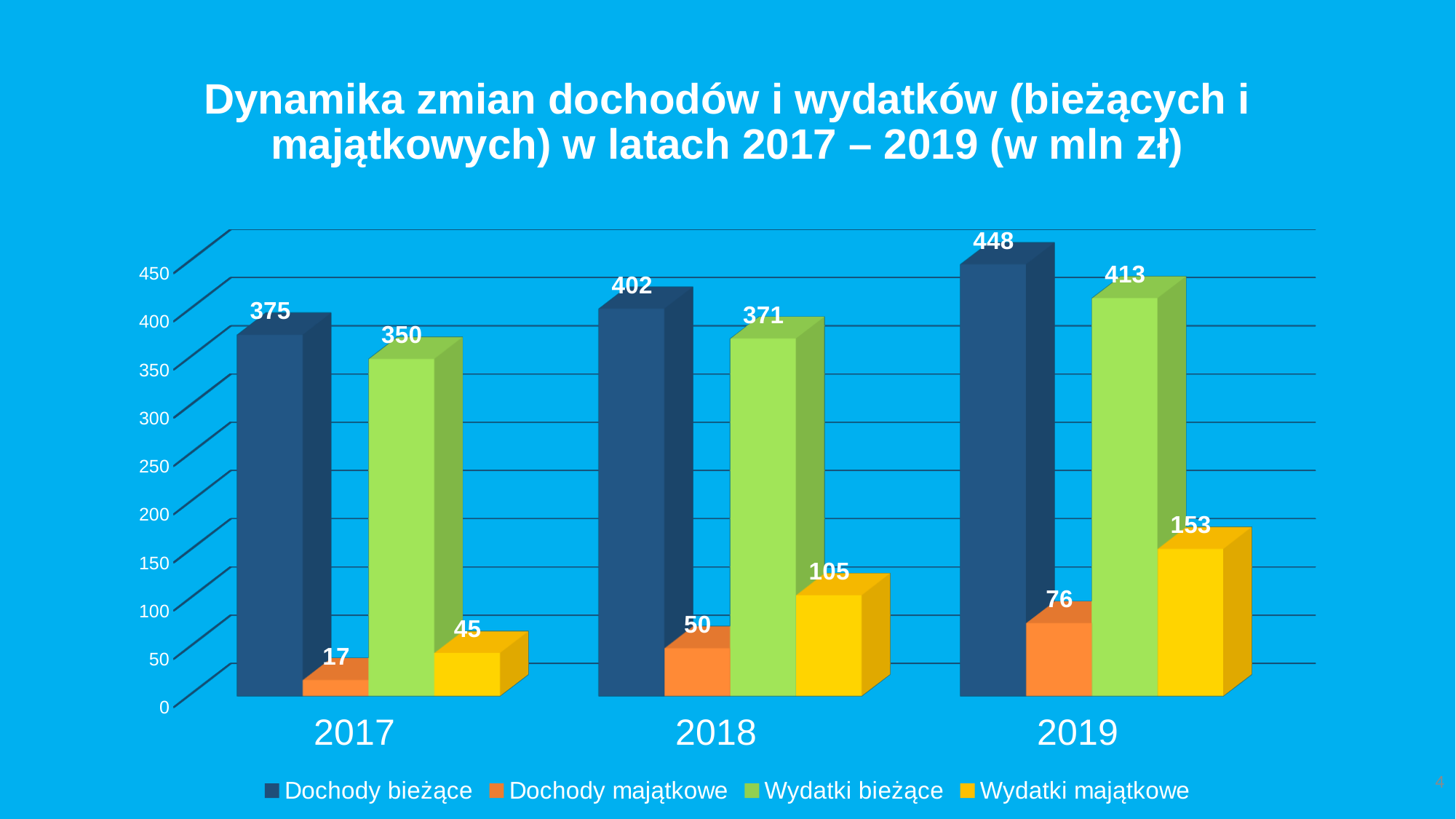
What is the value of Dochody majątkowe in 2018? 50 In which year is Dochody bieżące highest? 2019 What is the difference between Dochody bieżące and Wydatki bieżące in 2018? 31 What is the value of Dochody bieżące in 2017? 375 Which is larger in 2019: Dochody bieżące or Wydatki bieżące? Dochody bieżące How many series does the legend list? 4 Which series is shown in yellow in the legend? Wydatki majątkowe In which year is Wydatki majątkowe lowest? 2017 What is the value of Wydatki majątkowe in 2019? 153 How many years are shown on the x axis? 3 What kind of chart is shown on the slide? Bar chart Do the values for Dochody majątkowe rise or fall from 2017 to 2019? Rise